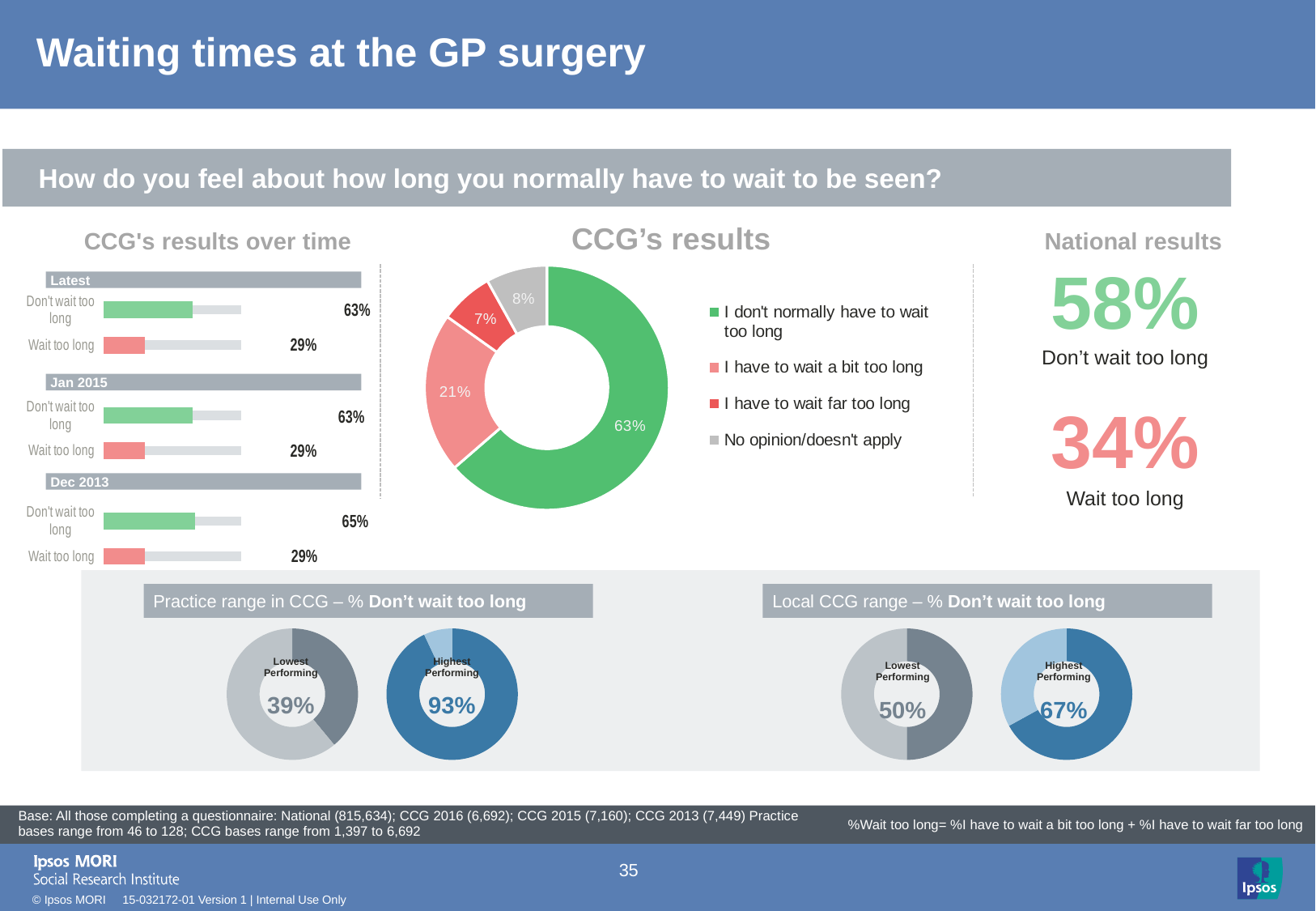
How many entries does the legend of the "CCG's results" donut chart list? 4 What type of chart is used for "CCG's results"? Donut (pie) chart In the "CCG's results over time" chart, did the "Don't wait too long" value rise or fall from Dec 2013 to the Latest period? Fall In the "CCG's results" donut chart, what percentage said "I have to wait far too long"? 7% In the "Practice range in CCG – % Don't wait too long" section, what is the Highest Performing value? 93% In the "CCG's results over time" chart, what is the "Wait too long" value for Jan 2015? 29% In the "CCG's results" donut chart, what percentage of respondents said "I don't normally have to wait too long"? 63% In the "CCG's results over time" chart, what is the "Don't wait too long" value for Dec 2013? 65% In the "CCG's results" donut chart, which response has the smallest share? I have to wait far too long In the "CCG's results over time" chart, what is the difference between "Don't wait too long" and "Wait too long" in the Latest period? 34 percentage points In the "Local CCG range – % Don't wait too long" section, what is the difference between the Highest Performing and Lowest Performing values? 17 percentage points In the "CCG's results" donut chart, what percentage said "I have to wait a bit too long"? 21%